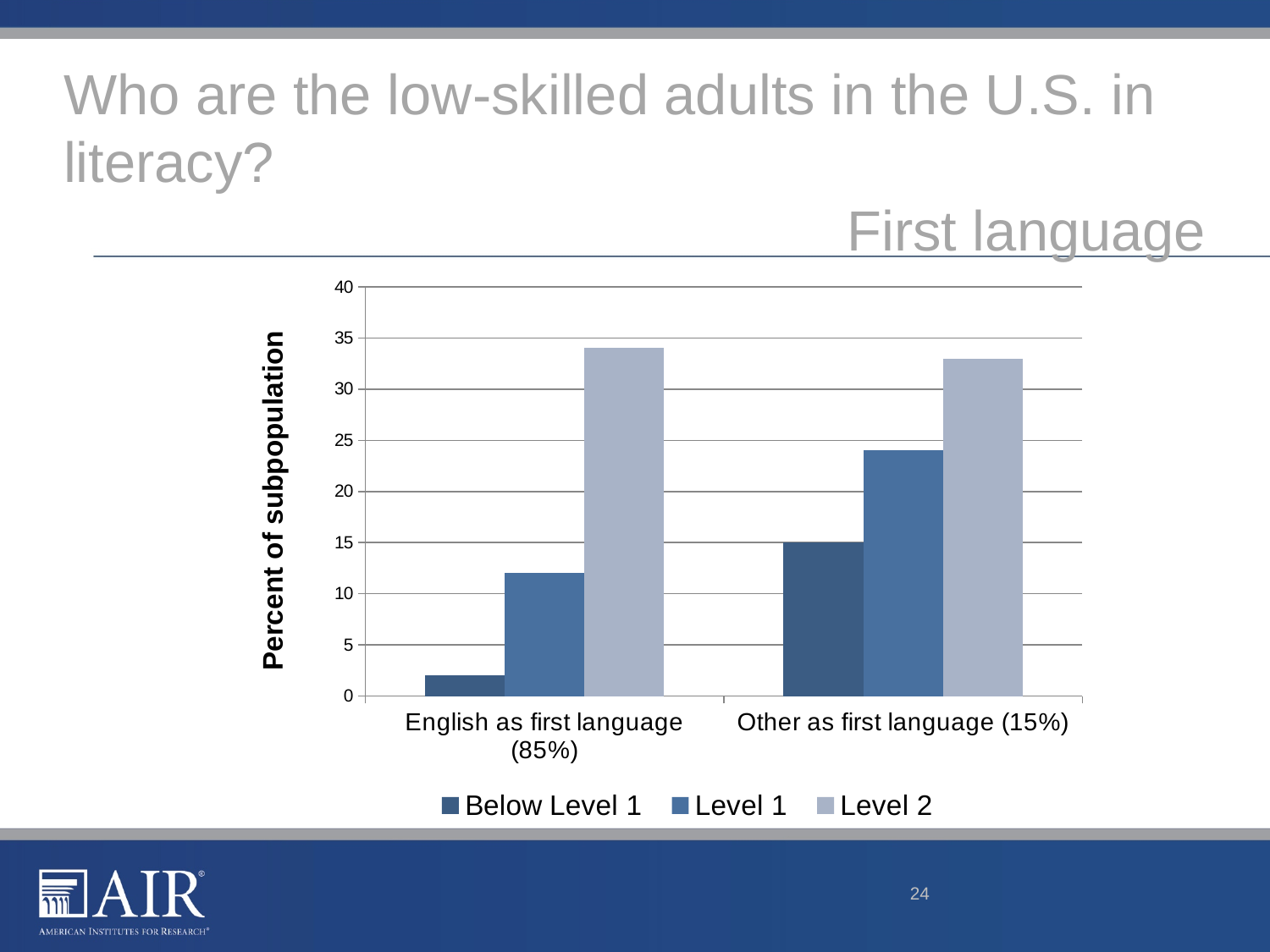
Which is larger: the Below Level 1 value for English as first language (85%) or for Other as first language (15%)? Other as first language (15%) Which series has the lowest value for Other as first language (15%)? Below Level 1 What kind of chart is shown on the slide? bar chart How many series does the legend list? 3 Is the Below Level 1 value for English as first language (85%) greater or less than 5? less Is the Level 1 value for Other as first language (15%) greater or less than 20? greater Which series has the highest value for English as first language (85%)? Level 2 Which series has the lowest value for English as first language (85%)? Below Level 1 Which is larger: the Level 1 value for English as first language (85%) or for Other as first language (15%)? Other as first language (15%) How many categories are shown on the x axis? 2 Is the Level 2 value for English as first language (85%) greater or less than 30? greater What is the label on the vertical axis of the chart? Percent of subpopulation